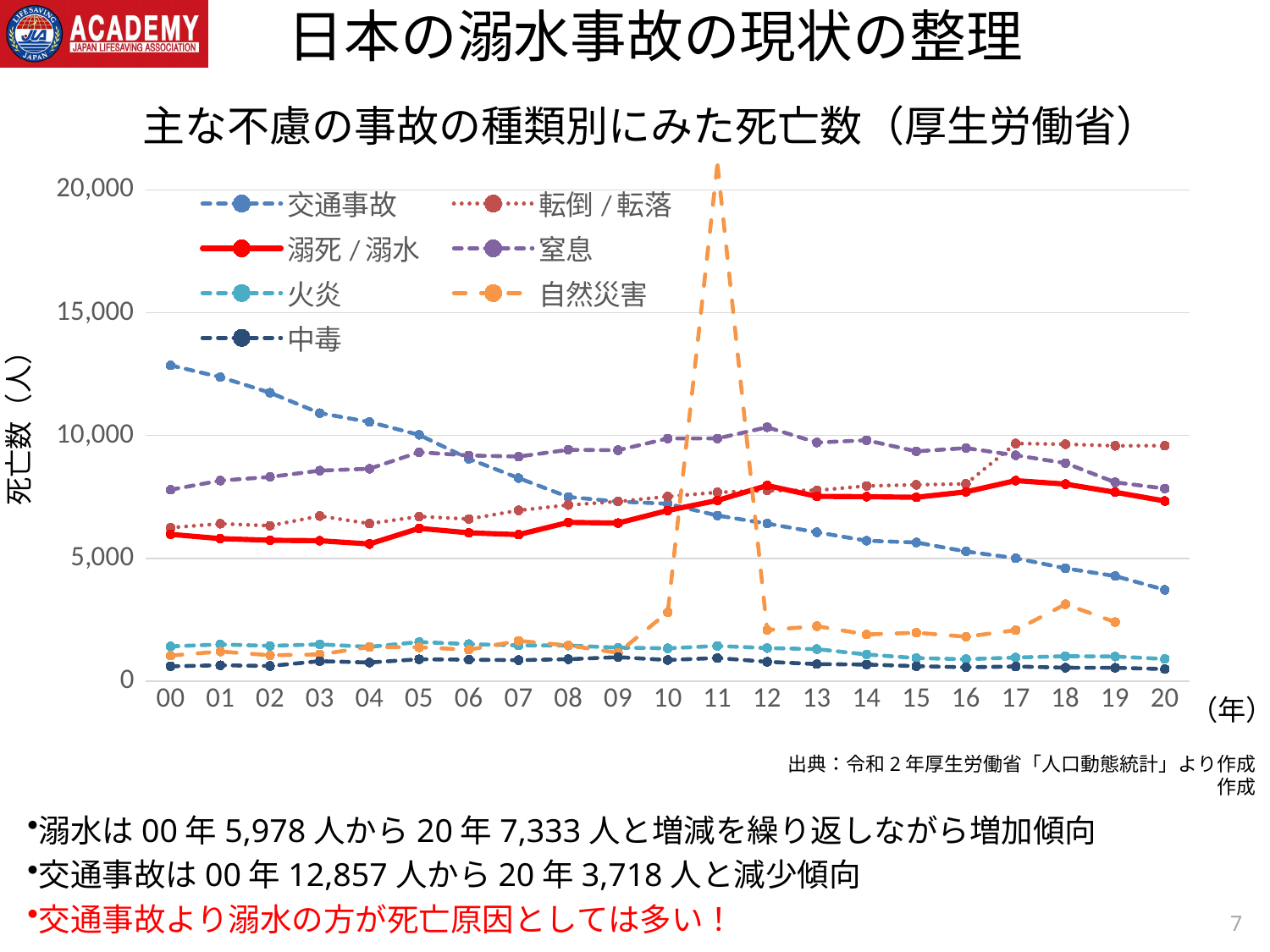
What is the value for 交通事故 in year 20? 3,718 What kind of chart is shown on the slide? line chart How many series does the legend list? 7 Which series has the highest value in year 00? 交通事故 What is the value for 交通事故 in year 00? 12,857 What is the value for 溺死／溺水 in year 00? 5,978 Does the value for 交通事故 rise or fall from year 00 to year 20? fall Is the value for 自然災害 in year 11 greater or less than 20,000? greater In year 20, which is larger: 溺死／溺水 or 交通事故? 溺死／溺水 By how much did the value for 交通事故 fall from year 00 to year 20? 9,139 What is the value for 溺死／溺水 in year 20? 7,333 How many years are plotted along the x axis? 21